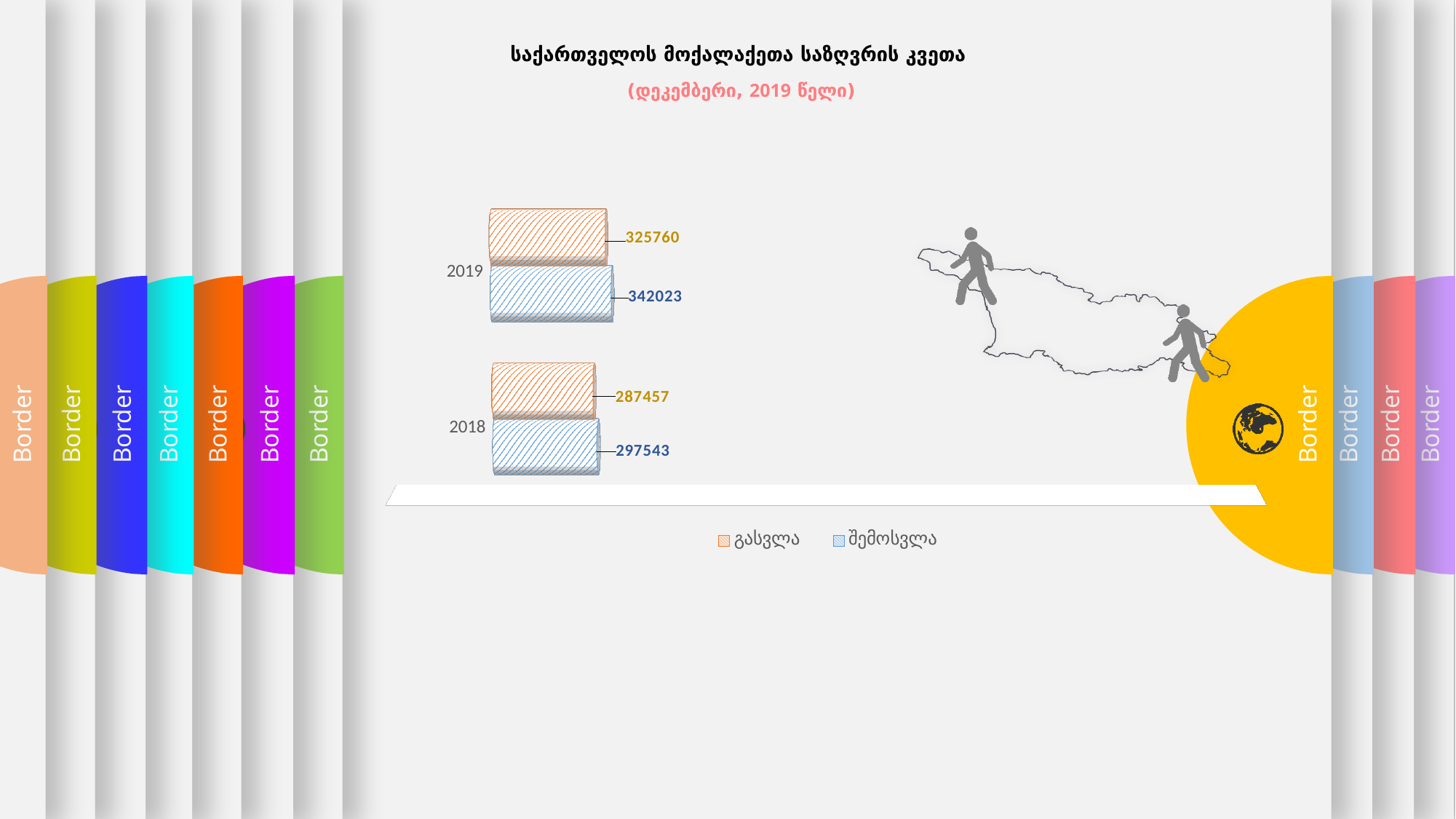
What is the difference between შემოსვლა and გასვლა in 2019? 16263 What is the value of შემოსვლა for 2019? 342023 In 2018, which is larger: გასვლა or შემოსვლა? შემოსვლა How many series does the legend list? 2 How many years (categories) are shown in the chart? 2 Which year has the higher value for შემოსვლა? 2019 What is the value of გასვლა for 2018? 287457 What is the difference between გასვლა in 2019 and გასვლა in 2018? 38303 What is the value of გასვლა for 2019? 325760 What kind of chart is shown on the slide? Bar chart What is the value of შემოსვლა for 2018? 297543 Which year has the lower value for გასვლა? 2018